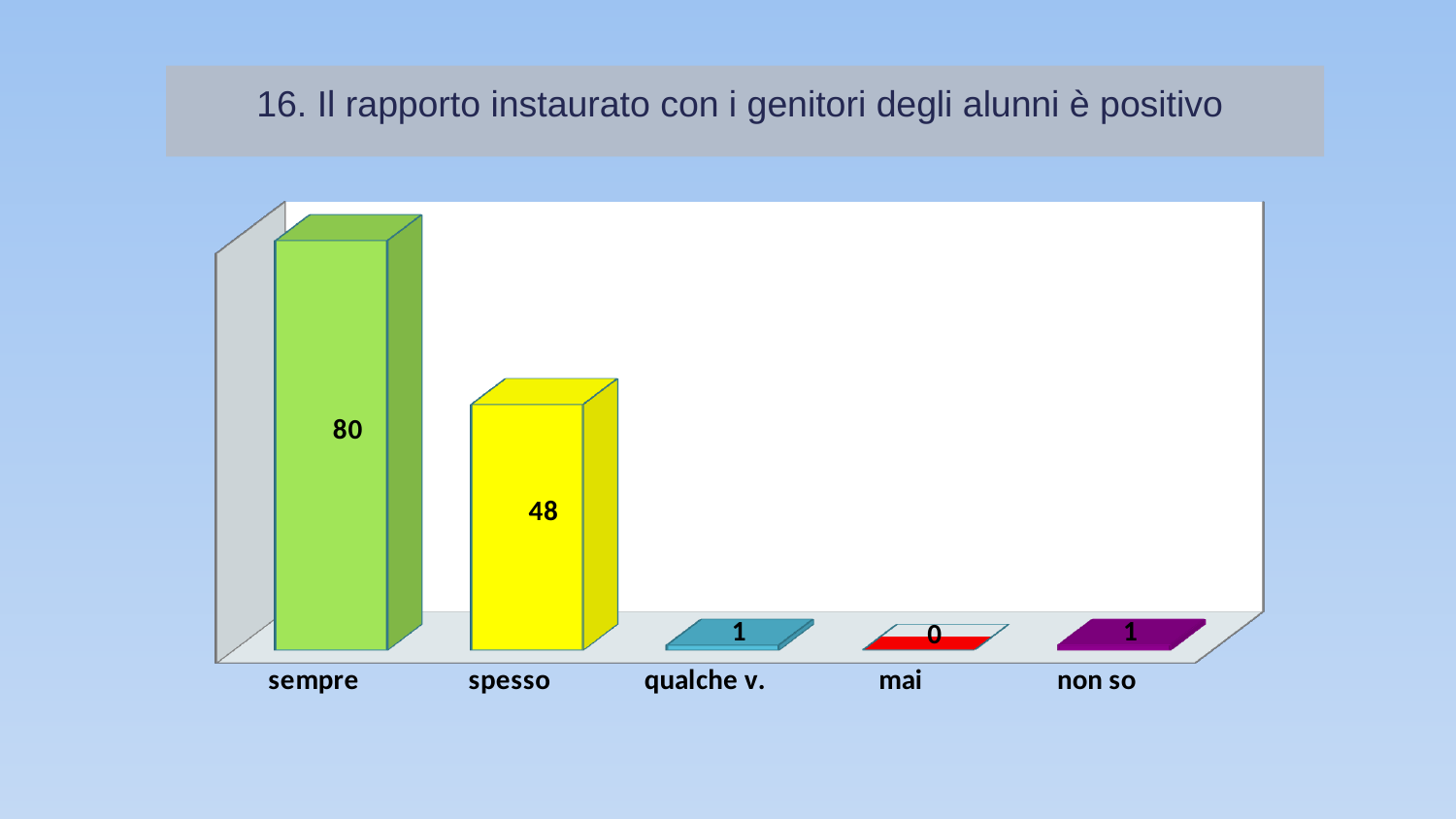
What is the value for "mai"? 0 What kind of chart is shown on the slide? bar chart What is the value for "sempre"? 80 What is the value for "qualche v."? 1 What is the difference between the values for "sempre" and "spesso"? 32 What is the value for "spesso"? 48 What is the value for "non so"? 1 Which is larger, the value for "spesso" or the value for "qualche v."? spesso What is the title of the slide above the chart? 16. Il rapporto instaurato con i genitori degli alunni è positivo Which category has the lowest value? mai How many categories are shown on the x axis? 5 Which category has the highest value? sempre